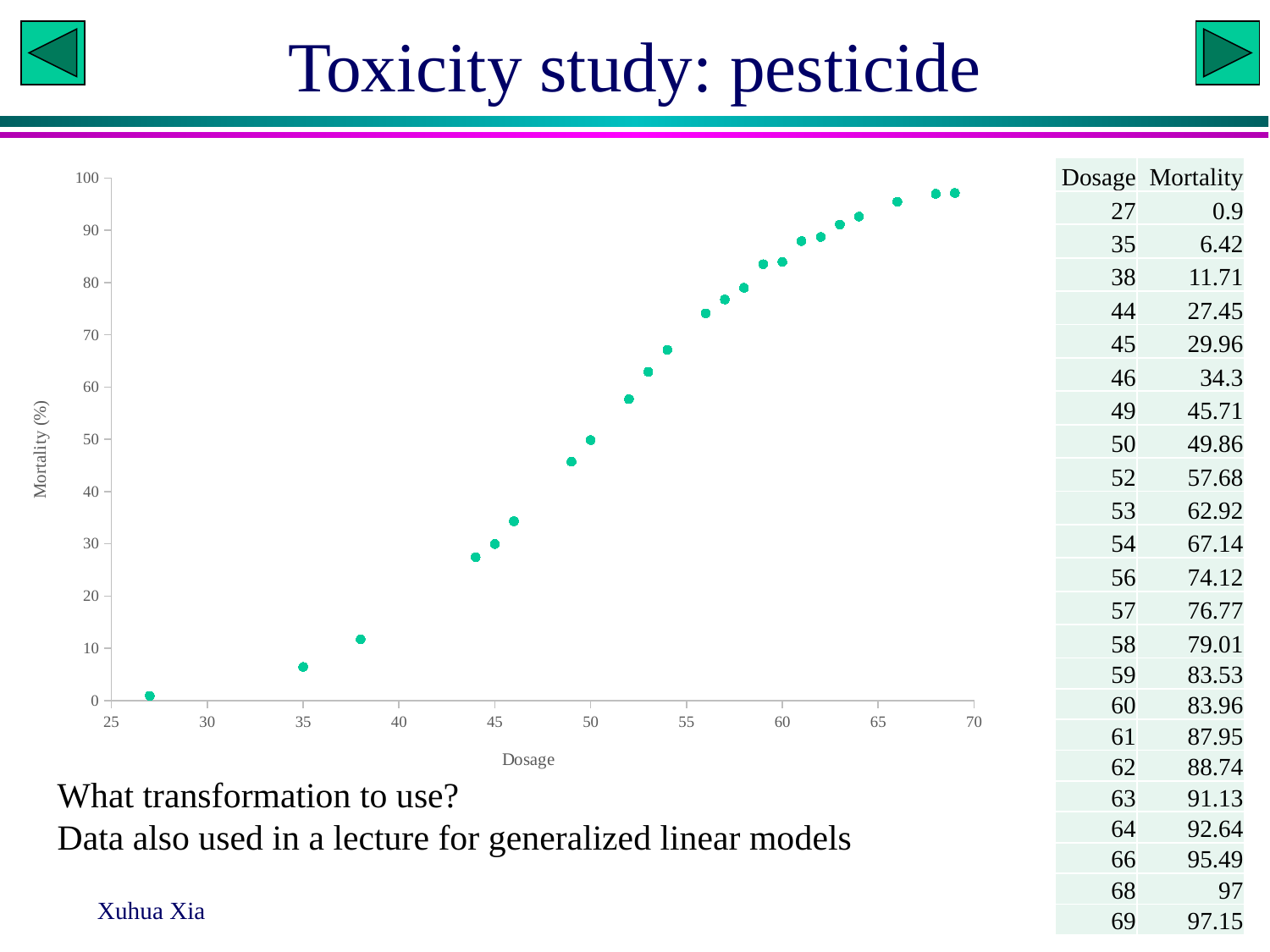
What kind of chart is shown on the slide? scatter chart At which dosage is mortality lowest? 27 What is the mortality value at a dosage of 27? 0.9 Which dosage has the higher mortality, 46 or 56? 56 What is the difference in mortality between dosage 69 and dosage 27? 96.25 At which dosage is mortality highest? 69 Do the mortality values rise or fall as dosage increases along the x axis? rise Is the mortality value at dosage 38 greater or less than 20? less What is the label on the x axis of the chart? Dosage What is the mortality value at a dosage of 50? 49.86 What is the label on the y axis of the chart? Mortality (%) How many data points are plotted in the chart? 23